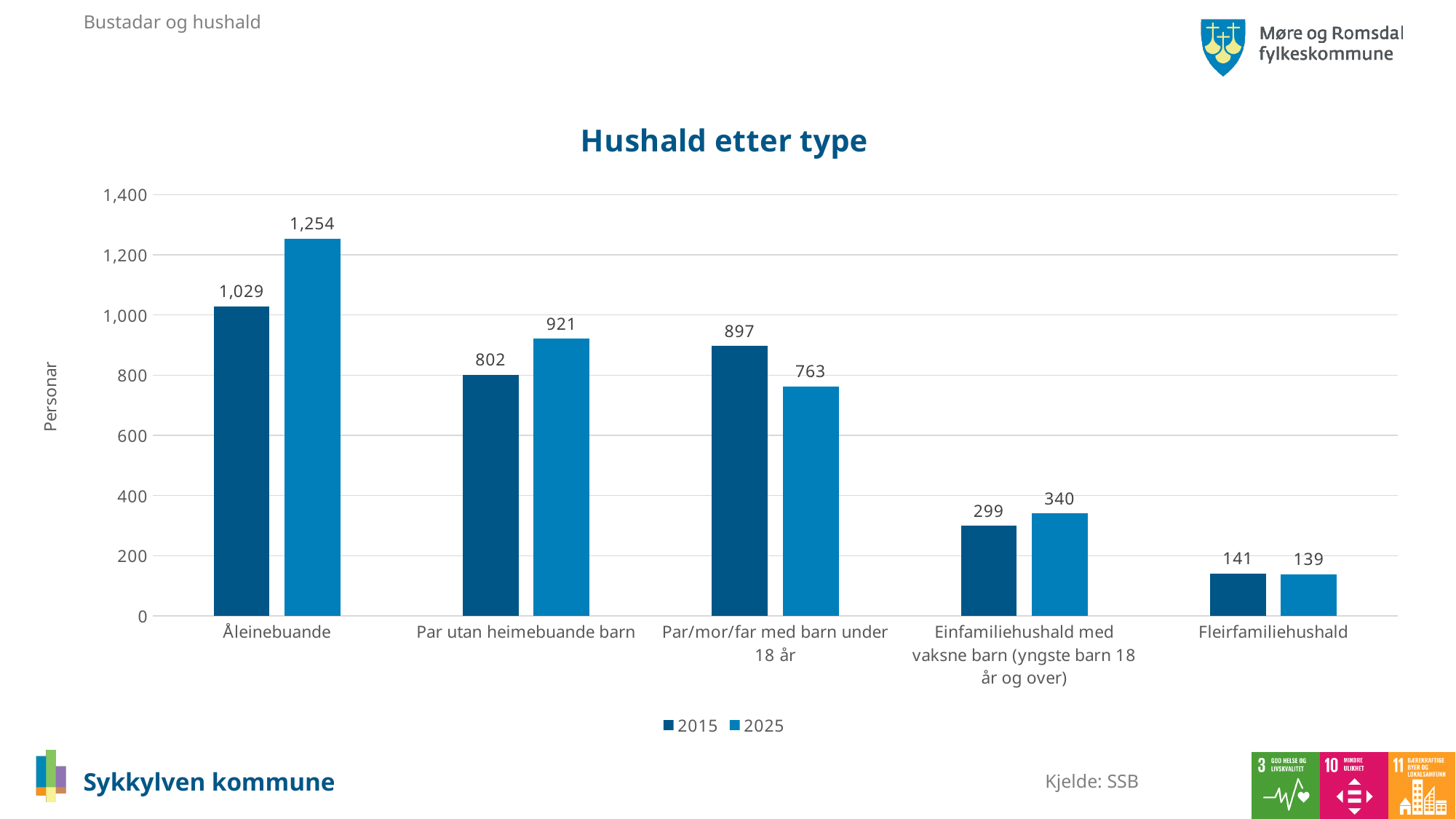
What kind of chart is shown? bar chart What is the value for Par utan heimebuande barn in 2015? 802 Which category has the lowest value in 2025? Fleirfamiliehushald What is the 2025 value for Par/mor/far med barn under 18 år? 763 How many series does the legend list? 2 How many household categories are shown on the x axis? 5 What is the value for Åleinebuande in 2025? 1,254 What is the title of the chart? Hushald etter type Is the 2025 value for Einfamiliehushald med vaksne barn (yngste barn 18 år og over) greater or less than 400? less Which category has the highest value in 2015? Åleinebuande Which is larger for Par/mor/far med barn under 18 år: the 2015 value or the 2025 value? 2015 What is the difference between the 2025 and 2015 values for Åleinebuande? 225